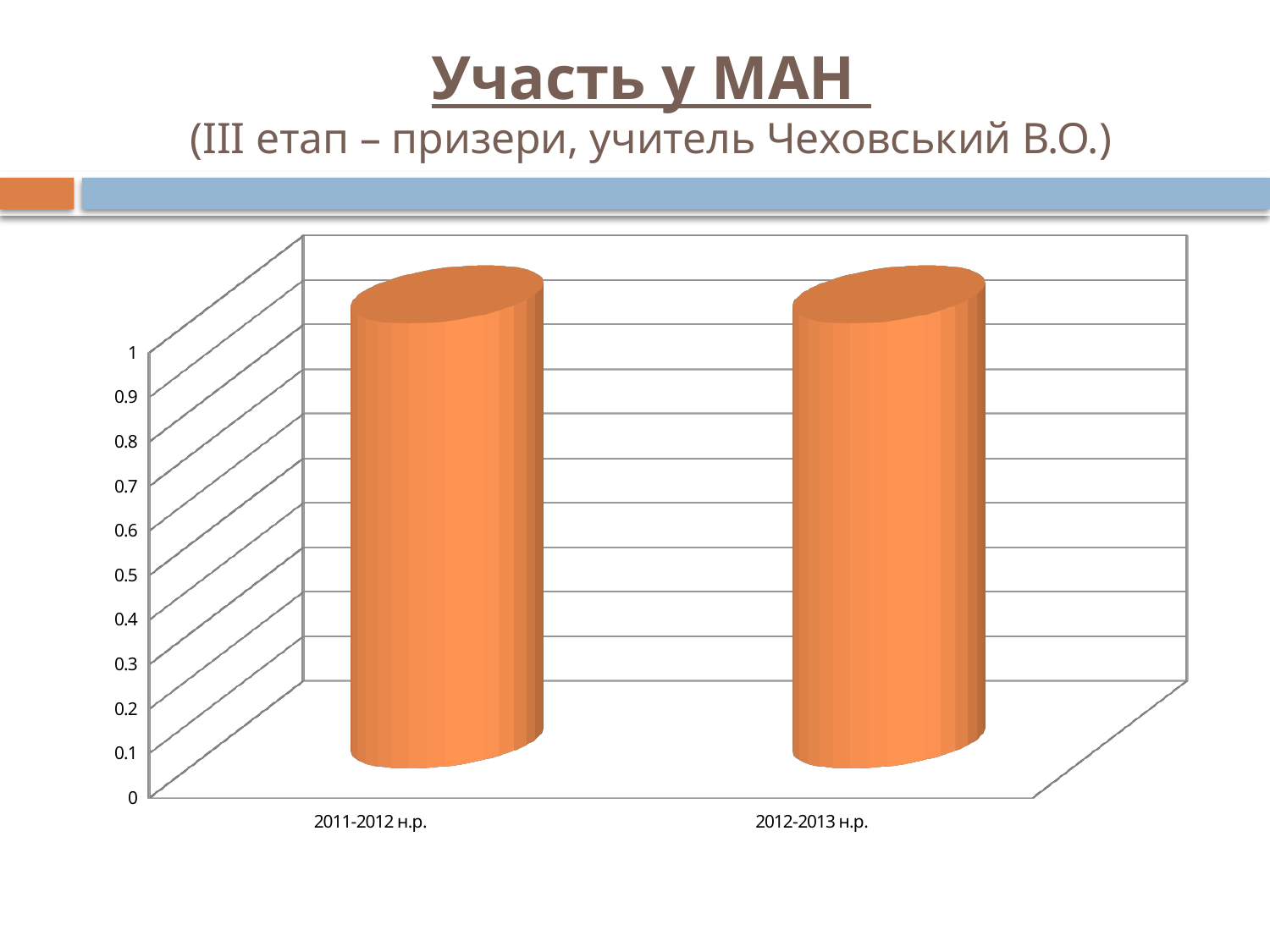
What kind of chart is shown on the slide? bar chart Is the value for 2012-2013 н.р. greater or less than 0.5? greater Is the value for 2011-2012 н.р. greater or less than 0.5? greater What is the highest value shown on the vertical axis of the chart? 1 Is the value for 2011-2012 н.р. greater or less than 0.8? greater How many categories are shown on the x axis of the chart? 2 What is the first category label on the x axis of the chart? 2011-2012 н.р.